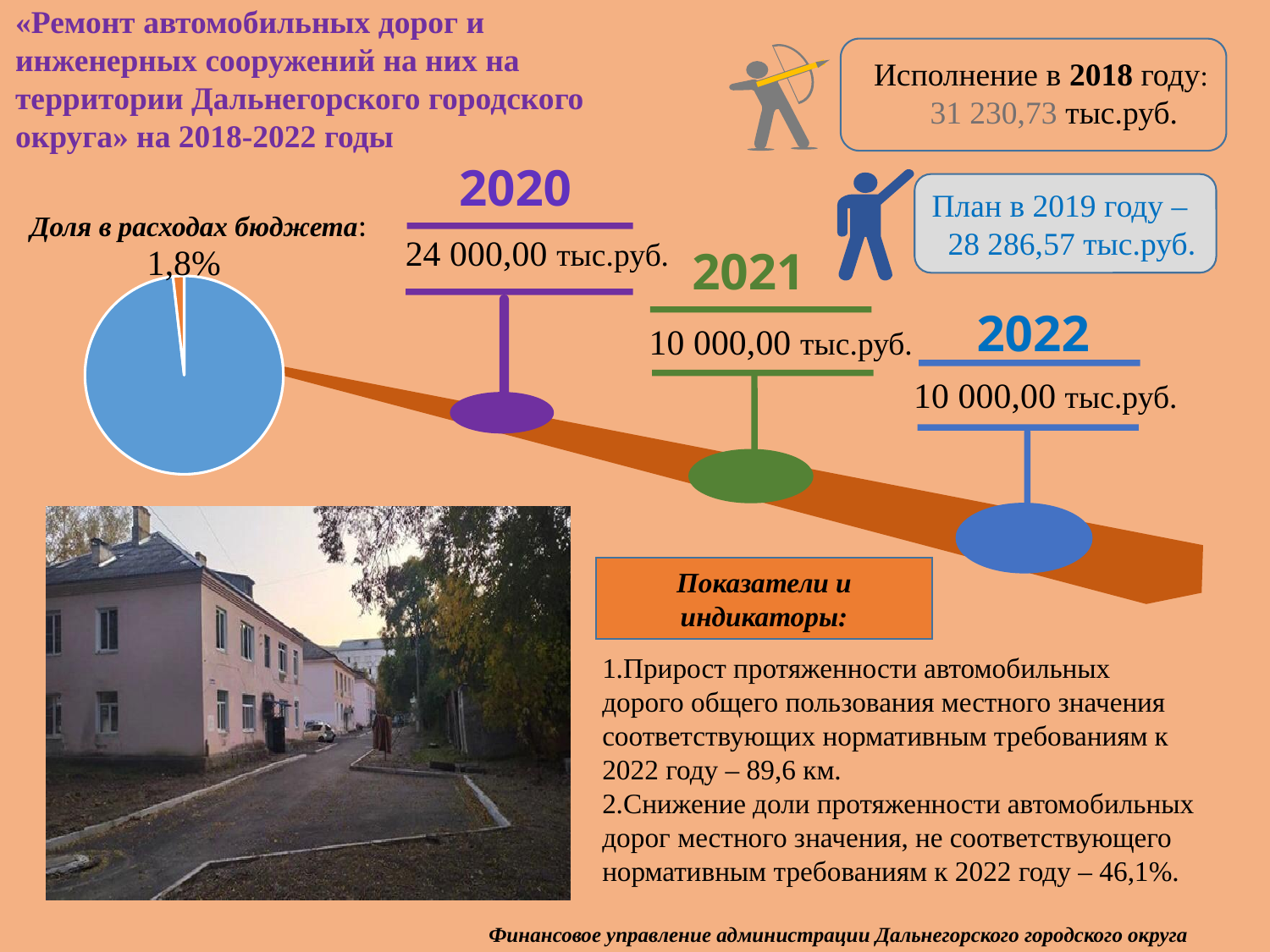
What kind of chart is the chart titled «Доля в расходах бюджета»? pie chart On the timeline graphic, what amount is shown for 2022? 10 000,00 тыс.руб. In the pie chart «Доля в расходах бюджета», which slice is larger, the blue one or the orange one? the blue one In the pie chart «Доля в расходах бюджета», what value is printed on the small orange slice? 1,8% On the timeline graphic, which year has the highest amount? 2020 On the timeline graphic, what amount is shown for 2021? 10 000,00 тыс.руб. In the pie chart «Доля в расходах бюджета», what share of the pie does the orange slice represent? 1,8% On the timeline graphic, what is the difference between the amounts for 2020 and 2021? 14 000,00 тыс.руб. How many years are marked on the timeline graphic? 3 On the timeline graphic, what amount is shown for 2020? 24 000,00 тыс.руб. What is the title of the pie chart on the left of the slide? Доля в расходах бюджета How many slices does the pie chart «Доля в расходах бюджета» have? 2